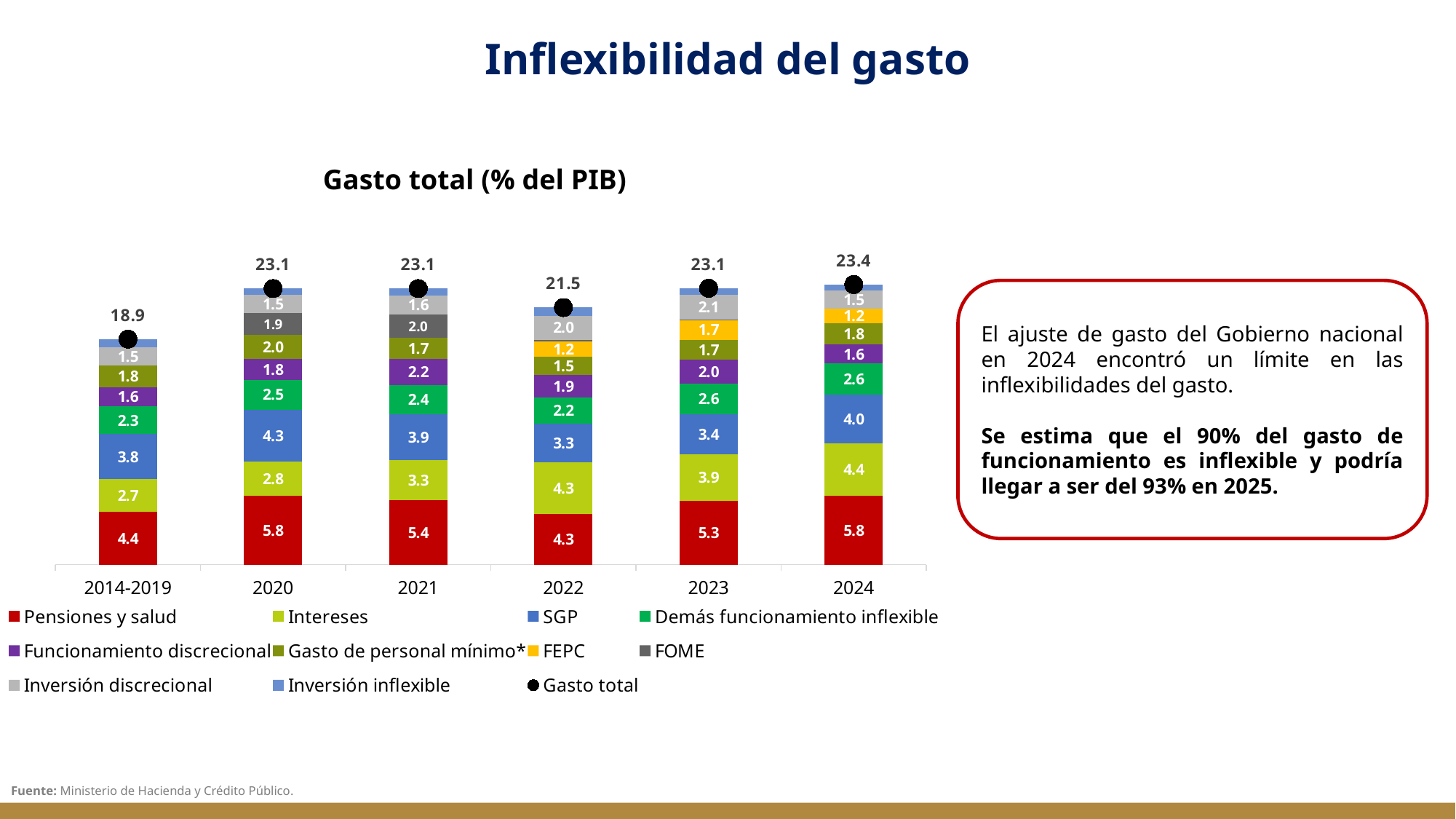
What is the FOME value in 2021? 2.0 How many entries does the legend list? 11 Which year has the larger SGP value, 2020 or 2021? 2020 What is the FEPC value in 2023? 1.7 What is the value for Pensiones y salud in 2024? 5.8 What is the Gasto total value shown for 2022? 21.5 What is the title of the chart? Gasto total (% del PIB) What is the difference between the Intereses value in 2024 and in 2014-2019? 1.7 Which period has the lowest Gasto total? 2014-2019 How many periods are shown on the x axis? 6 Which year has the highest Gasto total? 2024 What kind of chart is shown on the slide? Stacked bar chart